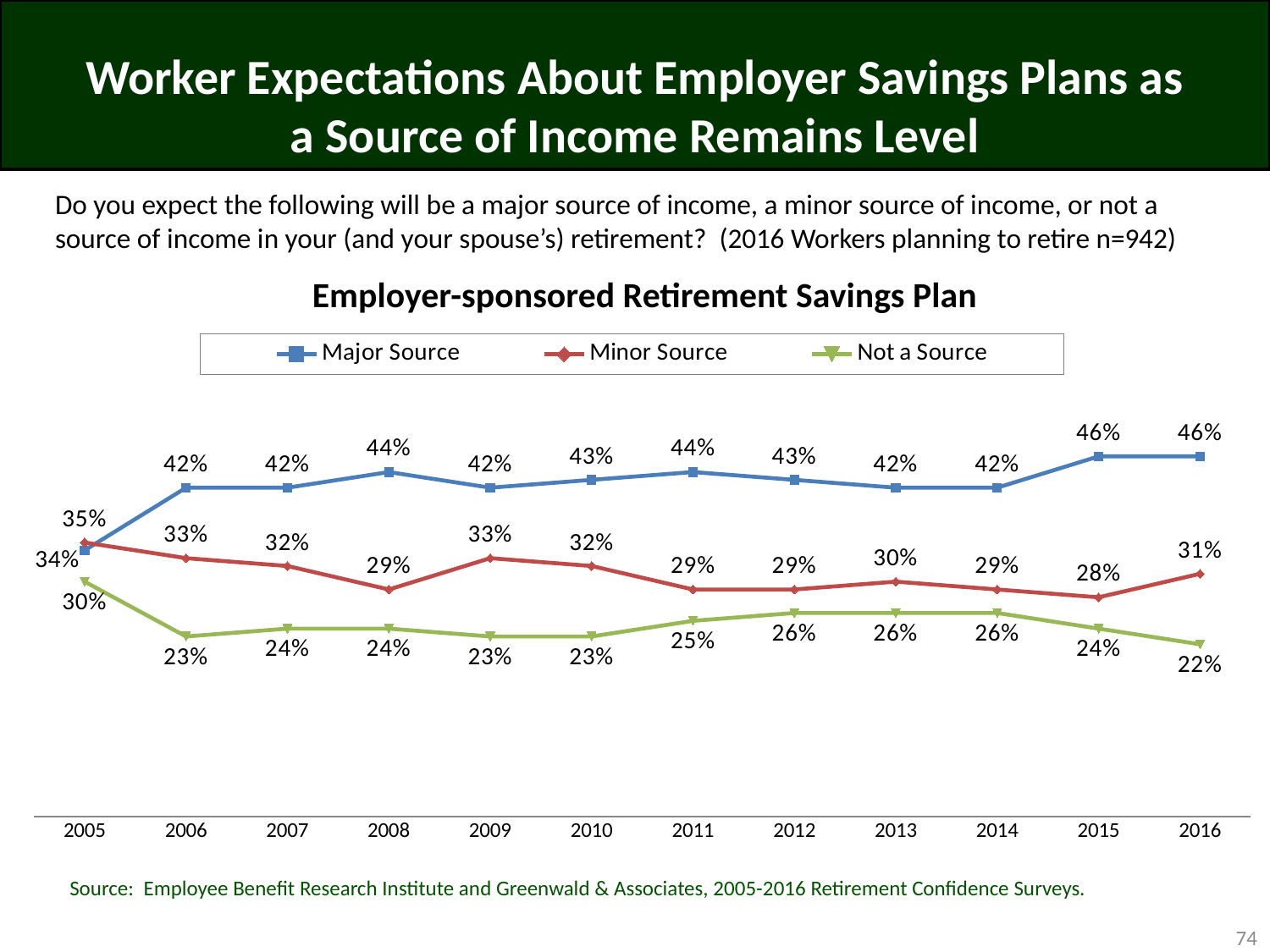
What is the difference between Major Source and Minor Source in 2016? 15 percentage points In which year is the Major Source series at its lowest? 2005 What is the value for Not a Source in 2005? 30% How many years are shown on the x axis? 12 What is the value for Major Source in 2016? 46% In which year is the Not a Source series at its lowest? 2016 What kind of chart is shown? Line chart How many series does the legend list? 3 Does the Not a Source series rise or fall from 2014 to 2016? Fall What is the title of the chart? Employer-sponsored Retirement Savings Plan What is the value for Minor Source in 2009? 33% Which is larger in 2005, Major Source or Minor Source? Minor Source